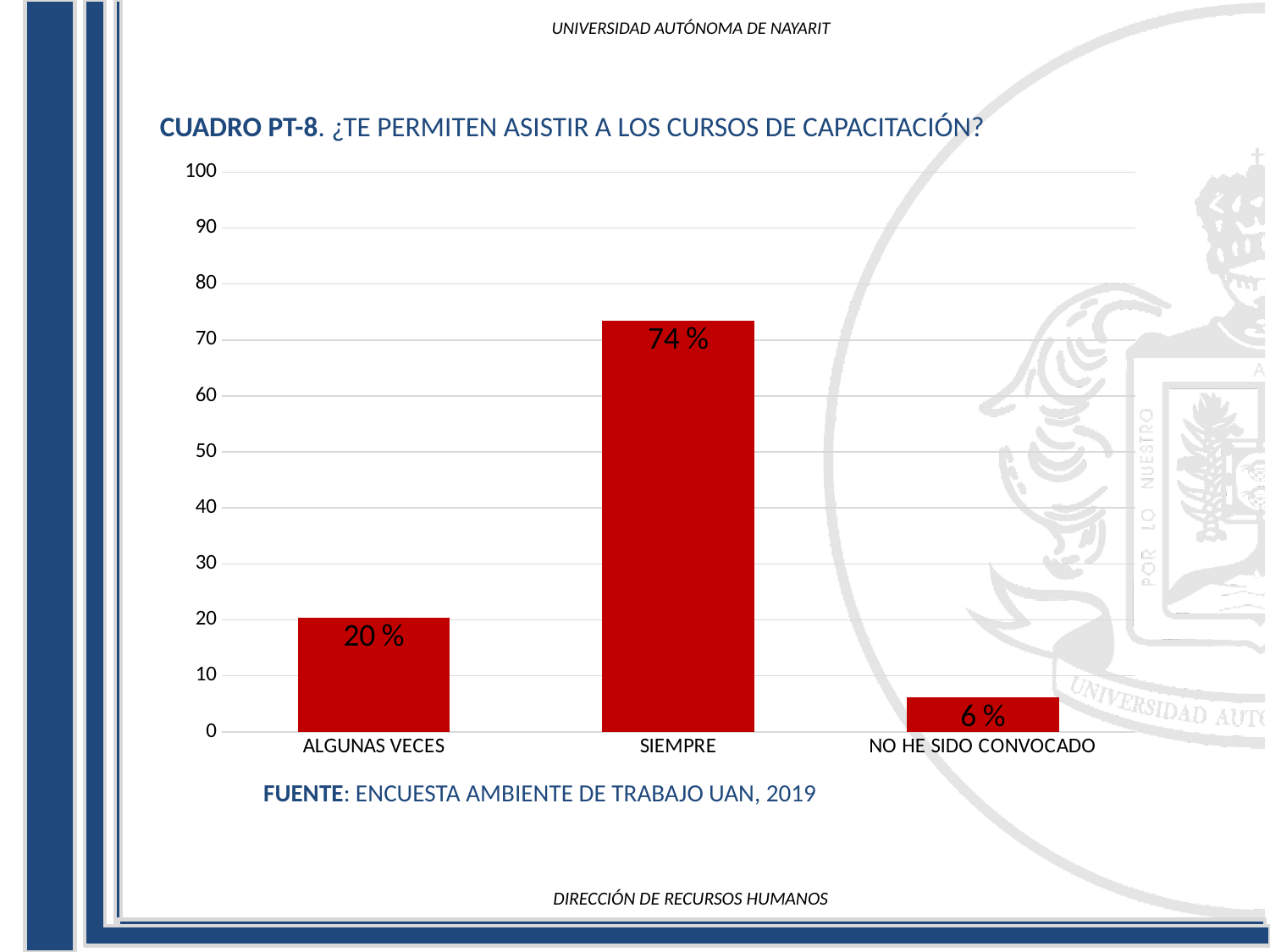
What is the difference between the values for SIEMPRE and ALGUNAS VECES? 54 % Which category has the lowest value? NO HE SIDO CONVOCADO What is the value for ALGUNAS VECES? 20 % Which is larger, the value for ALGUNAS VECES or the value for NO HE SIDO CONVOCADO? ALGUNAS VECES What is the difference between the values for ALGUNAS VECES and NO HE SIDO CONVOCADO? 14 % Which category has the highest value? SIEMPRE How many categories are shown on the x axis? 3 What kind of chart is shown on the slide? bar chart What is the value for SIEMPRE? 74 % What is the source cited below the chart? ENCUESTA AMBIENTE DE TRABAJO UAN, 2019 Is the value for SIEMPRE greater or less than 70? greater What is the value for NO HE SIDO CONVOCADO? 6 %